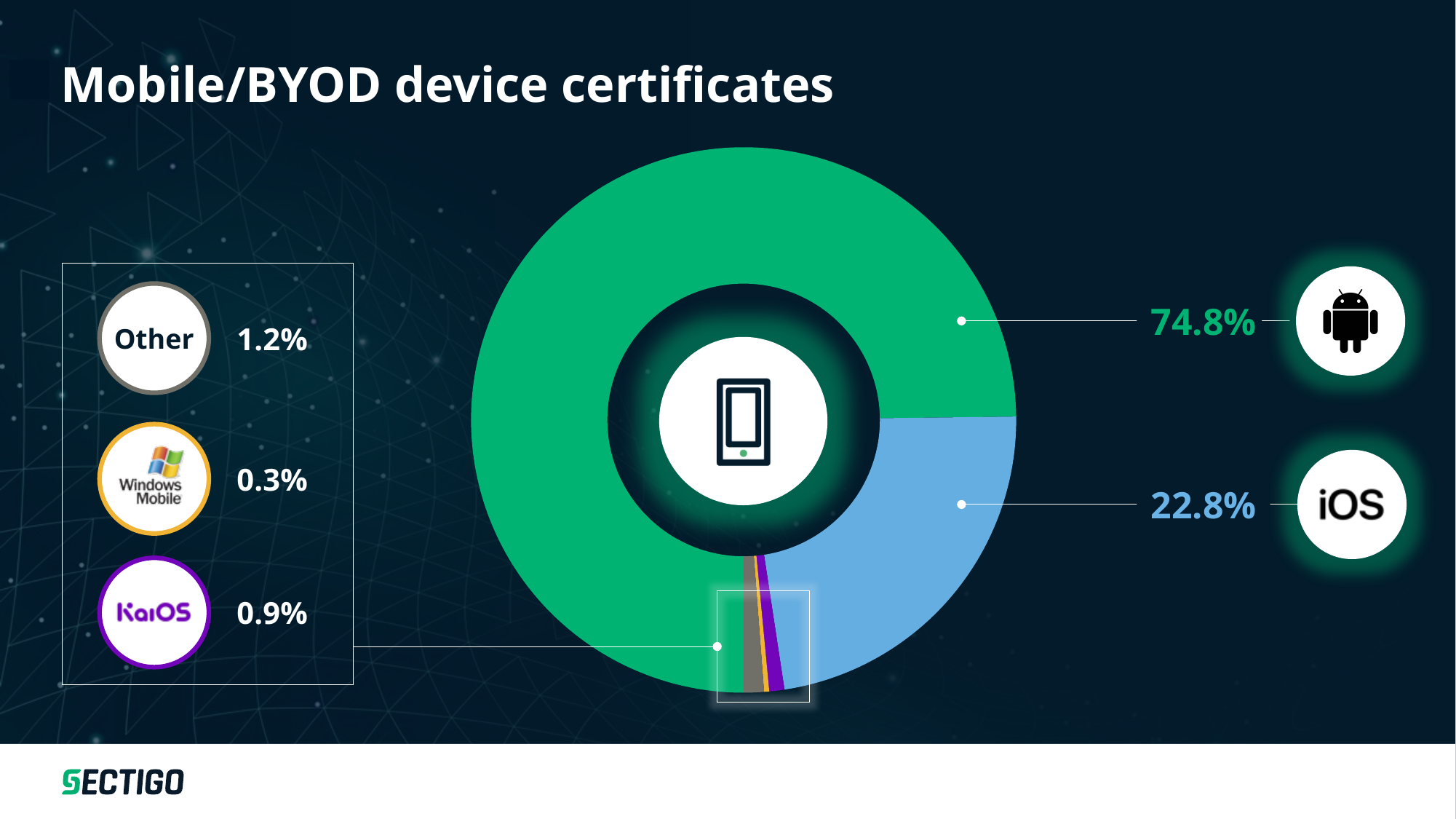
Which platform has the smallest share of Mobile/BYOD device certificates? Windows Mobile Which platform has the largest share of Mobile/BYOD device certificates? Android What percentage is shown for Windows Mobile? 0.3% What is the title of the slide? Mobile/BYOD device certificates How many categories are shown in the chart? 5 What share of Mobile/BYOD device certificates is for Android? 74.8% What kind of chart is used on the slide? Pie chart (donut) What is the difference in percentage points between the Android and iOS shares? 52 percentage points What share of Mobile/BYOD device certificates is for iOS? 22.8% What percentage is shown for the Other category? 1.2% Which has a larger share, KaiOS or Windows Mobile? KaiOS What percentage is shown for KaiOS? 0.9%